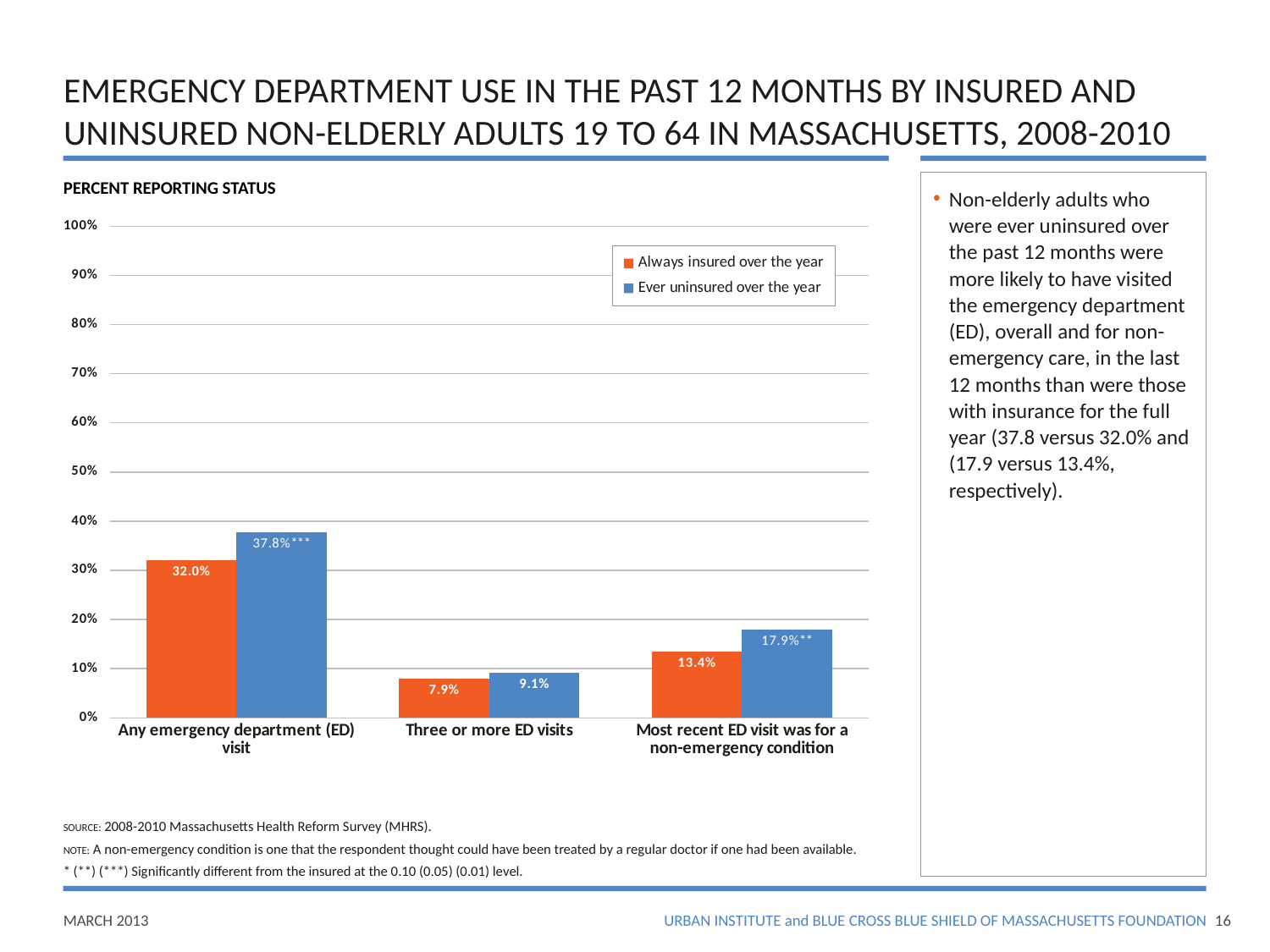
What percentage of adults ever uninsured over the year reported any emergency department (ED) visit? 37.8% What percentage of adults always insured over the year reported any emergency department (ED) visit? 32.0% What is the difference between the ever uninsured and always insured values for 'Most recent ED visit was for a non-emergency condition'? 4.5% Is the value for always insured adults reporting three or more ED visits greater or less than 10%? less What percentage of adults ever uninsured over the year reported three or more ED visits? 9.1% Which category has the highest value for the 'Ever uninsured over the year' series? Any emergency department (ED) visit Which category has the lowest value for the 'Always insured over the year' series? Three or more ED visits What percentage of adults always insured over the year reported that their most recent ED visit was for a non-emergency condition? 13.4% What kind of chart is shown on the slide? Bar chart How many series does the legend list? 2 How many categories are shown on the x axis of the chart? 3 For 'Any emergency department (ED) visit', which group has the larger value: always insured or ever uninsured? Ever uninsured over the year